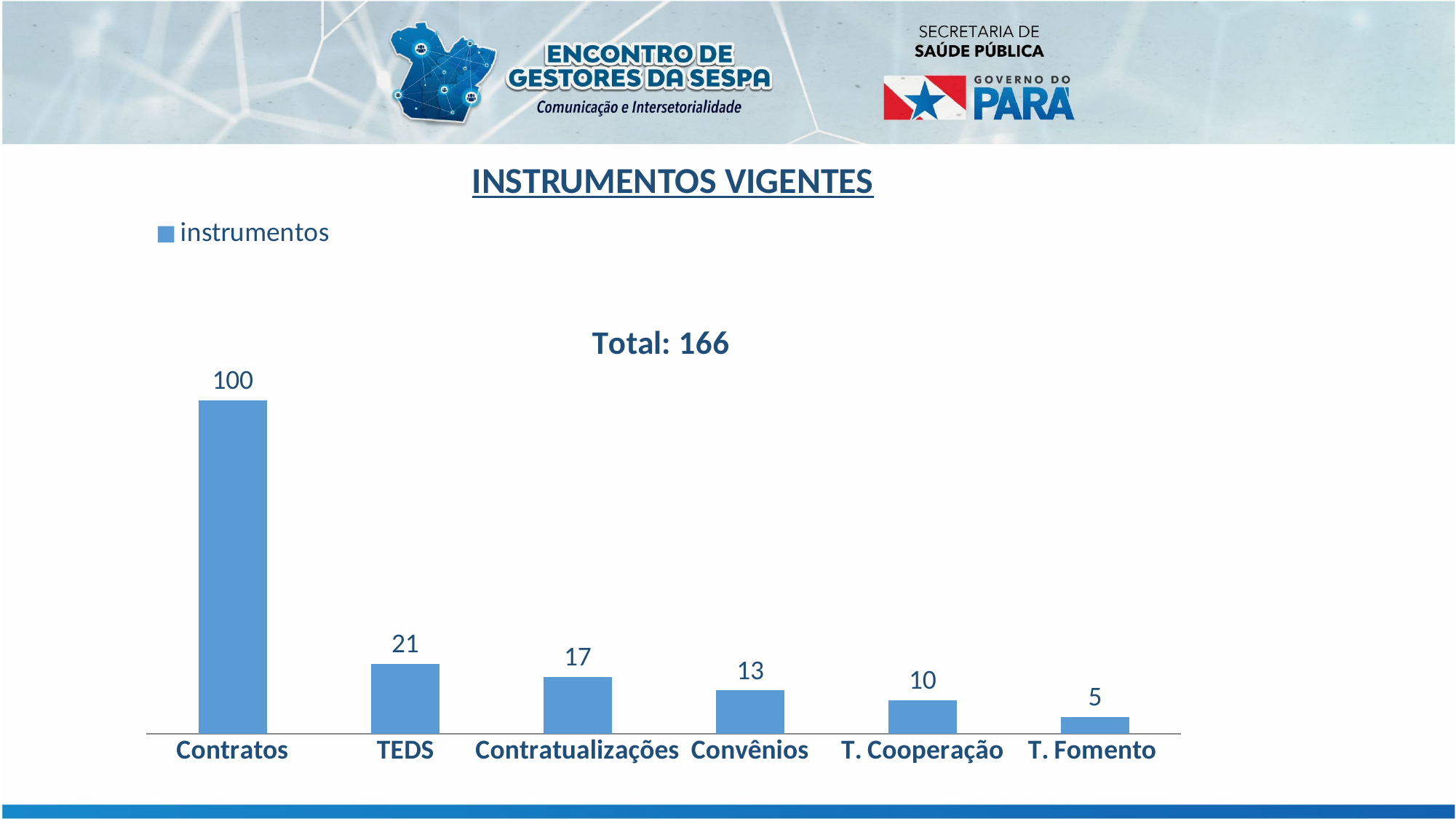
What total is printed above the chart? Total: 166 Which category has the highest value? Contratos What is the difference between the values for Contratos and TEDS? 79 What is the value for TEDS? 21 Which is larger, the value for Convênios or the value for T. Cooperação? Convênios How many categories are shown on the x axis? 6 What is the value for T. Fomento? 5 What kind of chart is shown on the slide? Bar chart What is the value for Contratos? 100 What is the value for Convênios? 13 Which category has the lowest value? T. Fomento What is the difference between the values for Contratualizações and T. Cooperação? 7